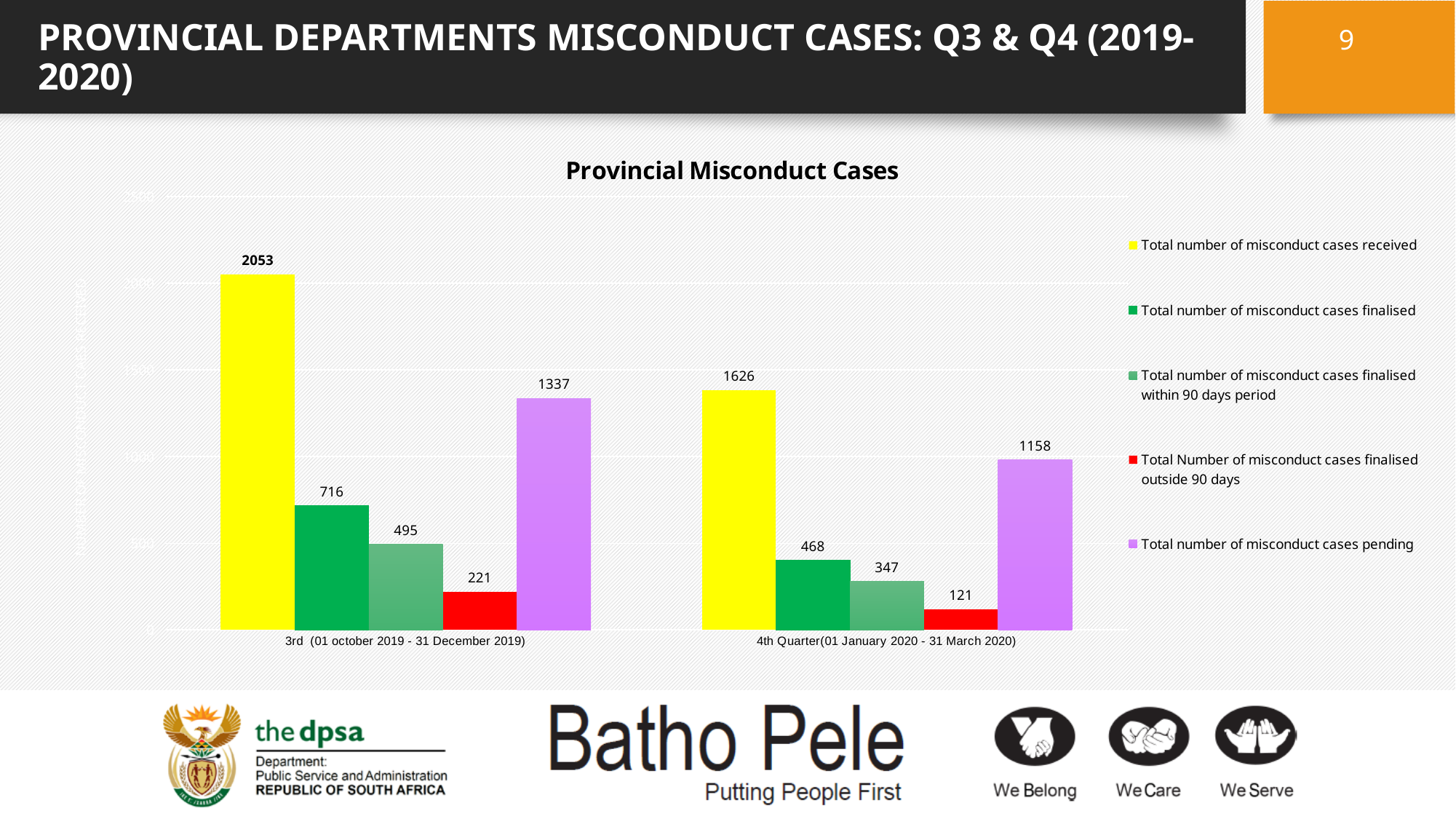
How many misconduct cases were finalised within the 90 days period in the 3rd quarter? 495 How many series does the legend list? 5 What is the difference between the total number of misconduct cases received in the 3rd quarter and in the 4th Quarter? 427 Which series has the lowest value in the 3rd quarter? Total Number of misconduct cases finalised outside 90 days What kind of chart is shown on the slide? Bar chart Which series has the highest value in the 4th Quarter? Total number of misconduct cases received What colour represents the total number of misconduct cases pending? Purple What is the total number of misconduct cases received in the 3rd quarter (01 October 2019 - 31 December 2019)? 2053 What is the difference between the total number of misconduct cases finalised in the 3rd quarter and in the 4th Quarter? 248 What is the total number of misconduct cases pending in the 4th Quarter (01 January 2020 - 31 March 2020)? 1158 How many misconduct cases were finalised outside 90 days in the 4th Quarter? 121 Which is larger: the number of misconduct cases pending in the 3rd quarter or in the 4th Quarter? 3rd quarter